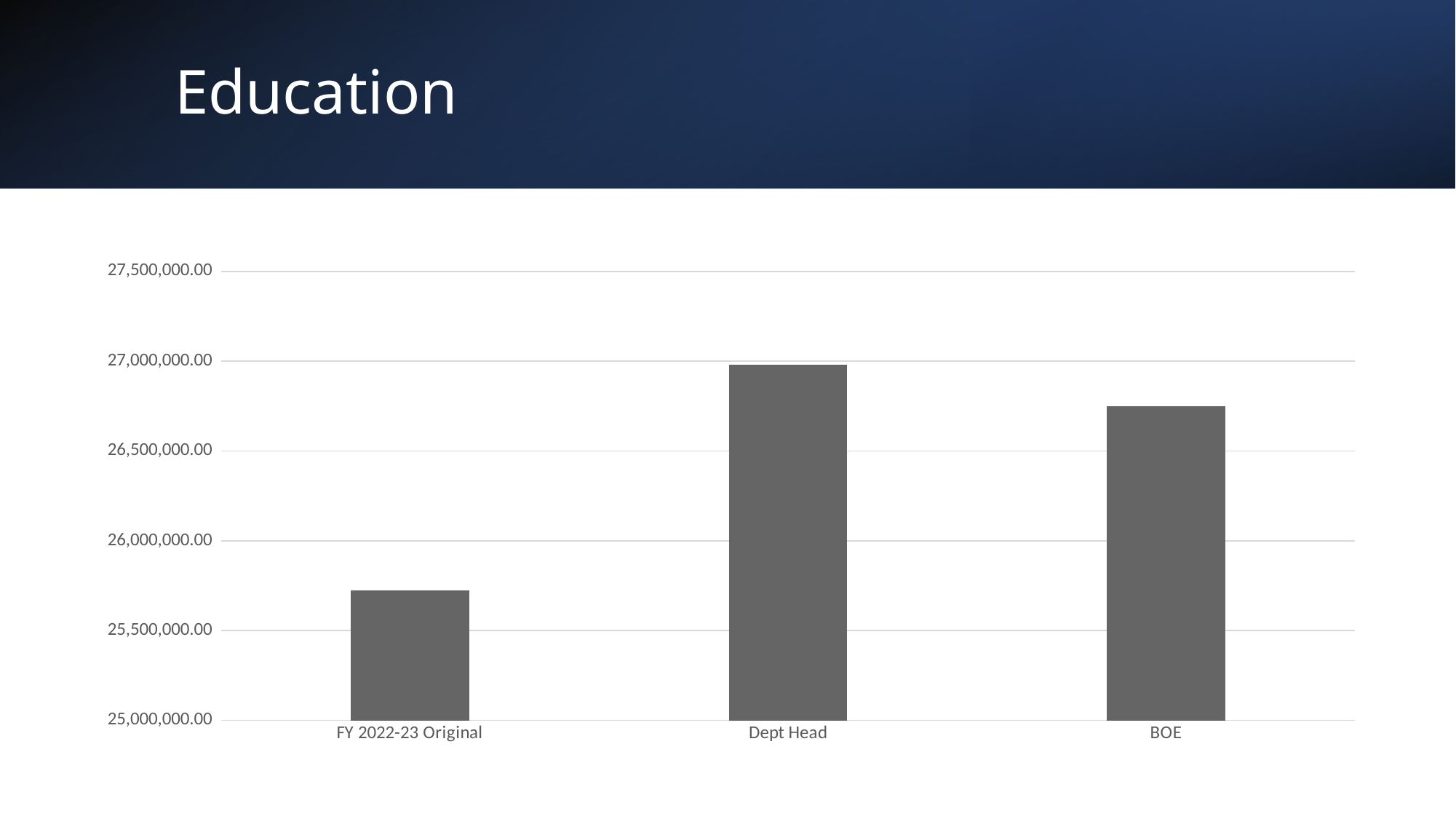
How many categories are shown on the x axis of the chart? 3 Is the value for BOE greater or less than 27,000,000.00? less What is the title of the slide containing the chart? Education What kind of chart is shown on the slide? Bar chart Is the value for FY 2022-23 Original greater or less than 25,500,000.00? greater Which is larger, the value for Dept Head or the value for BOE? Dept Head Is the value for FY 2022-23 Original greater or less than 26,000,000.00? less Which category has the lowest value in the chart? FY 2022-23 Original Does the value rise or fall from Dept Head to BOE? fall Which is larger, the value for FY 2022-23 Original or the value for BOE? BOE Which category has the highest value in the chart? Dept Head